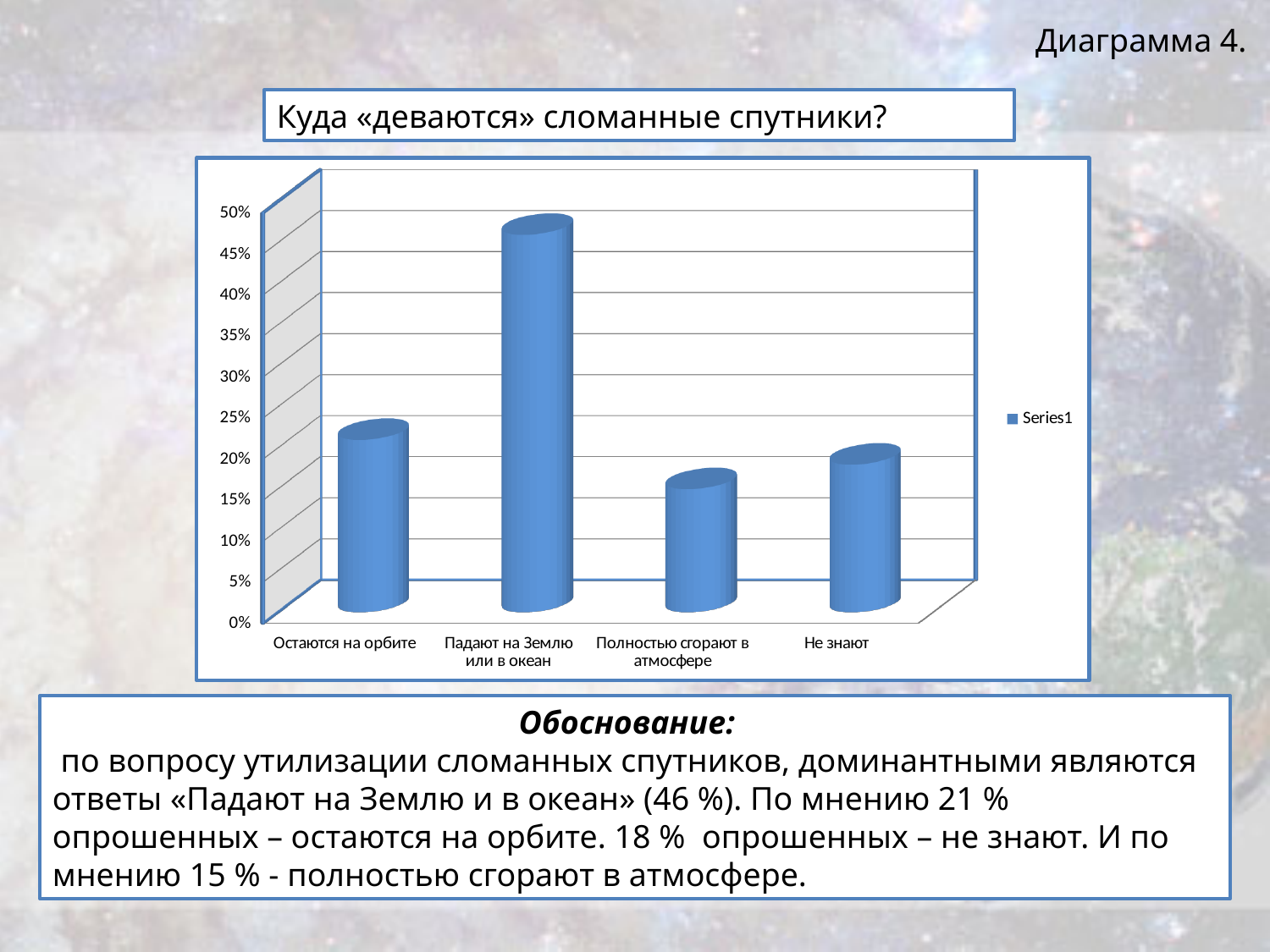
Is the value for «Остаются на орбите» greater or less than 25%? less According to the slide, what percentage of respondents answered «Остаются на орбите»? 21 % Which category has the highest bar in the chart? Падают на Землю или в океан How many series does the chart legend list? 1 Is the value for «Падают на Землю или в океан» greater or less than 40%? greater How many categories are shown on the x axis of the chart? 4 Is the value for «Полностью сгорают в атмосфере» greater or less than 20%? less Which category has the lowest bar in the chart? Полностью сгорают в атмосфере What kind of chart is shown on the slide? bar chart Which bar is taller: «Остаются на орбите» or «Не знают»? Остаются на орбите What is the title shown above the chart? Куда «деваются» сломанные спутники? According to the slide, what percentage of respondents answered «Падают на Землю или в океан»? 46 %